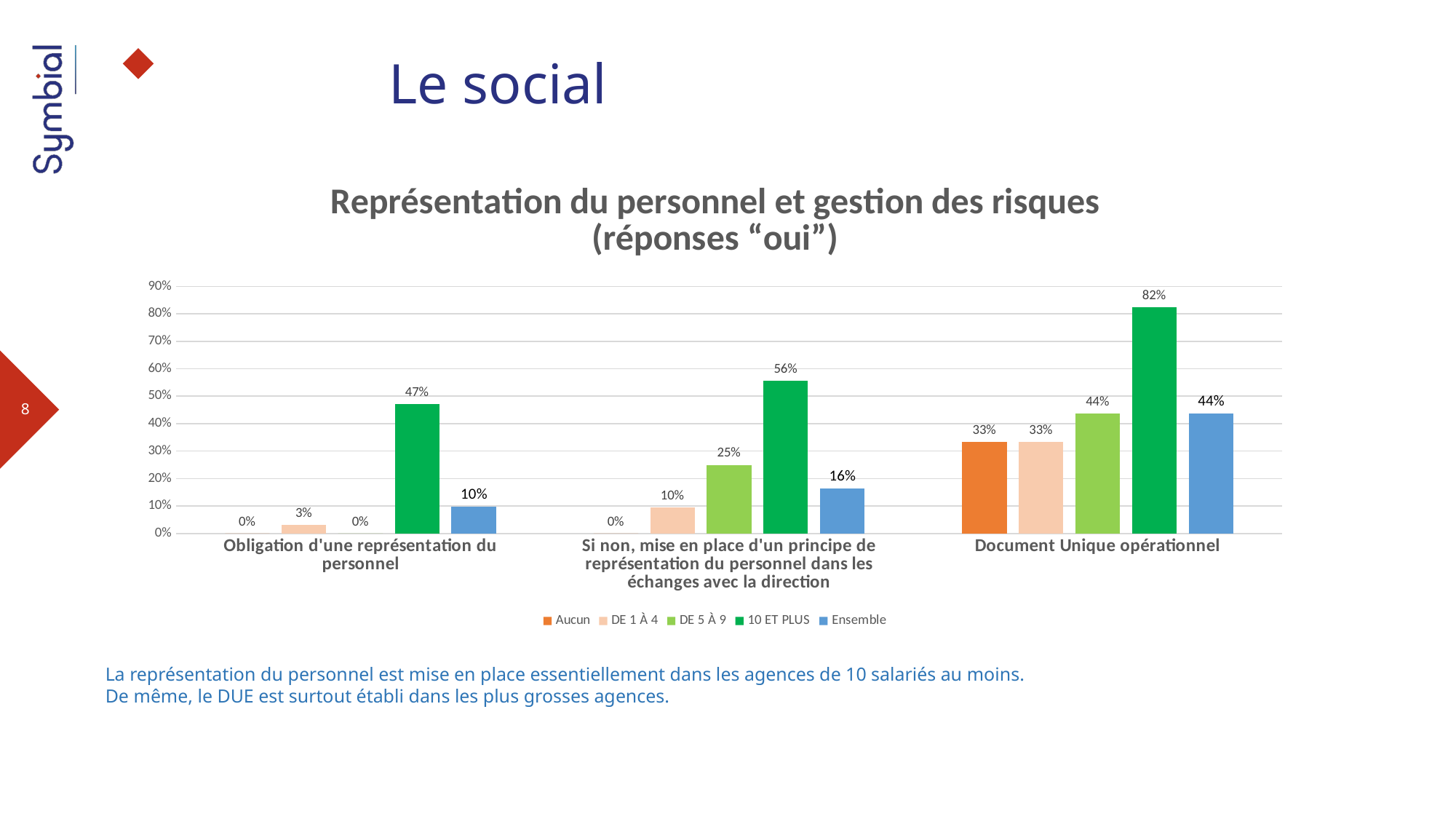
What is the value for 'DE 5 À 9' in the 'Si non, mise en place d'un principe de représentation du personnel dans les échanges avec la direction' category? 25% What is the value for 'DE 1 À 4' in the 'Obligation d'une représentation du personnel' category? 3% What is the value for '10 ET PLUS' in the 'Document Unique opérationnel' category? 82% What is the value for 'Ensemble' in the 'Obligation d'une représentation du personnel' category? 10% Which series has the highest value in the 'Document Unique opérationnel' category? 10 ET PLUS What kind of chart is shown on the slide? Bar chart Which category has the lowest value for the 'Ensemble' series? Obligation d'une représentation du personnel How many categories are shown on the x axis? 3 How many series does the legend list? 5 What is the difference between the '10 ET PLUS' value and the 'Ensemble' value in the 'Document Unique opérationnel' category? 38% Which is larger in the 'Si non, mise en place d'un principe de représentation du personnel dans les échanges avec la direction' category: 'DE 5 À 9' or 'Ensemble'? DE 5 À 9 What is the title of the chart? Représentation du personnel et gestion des risques (réponses “oui”)